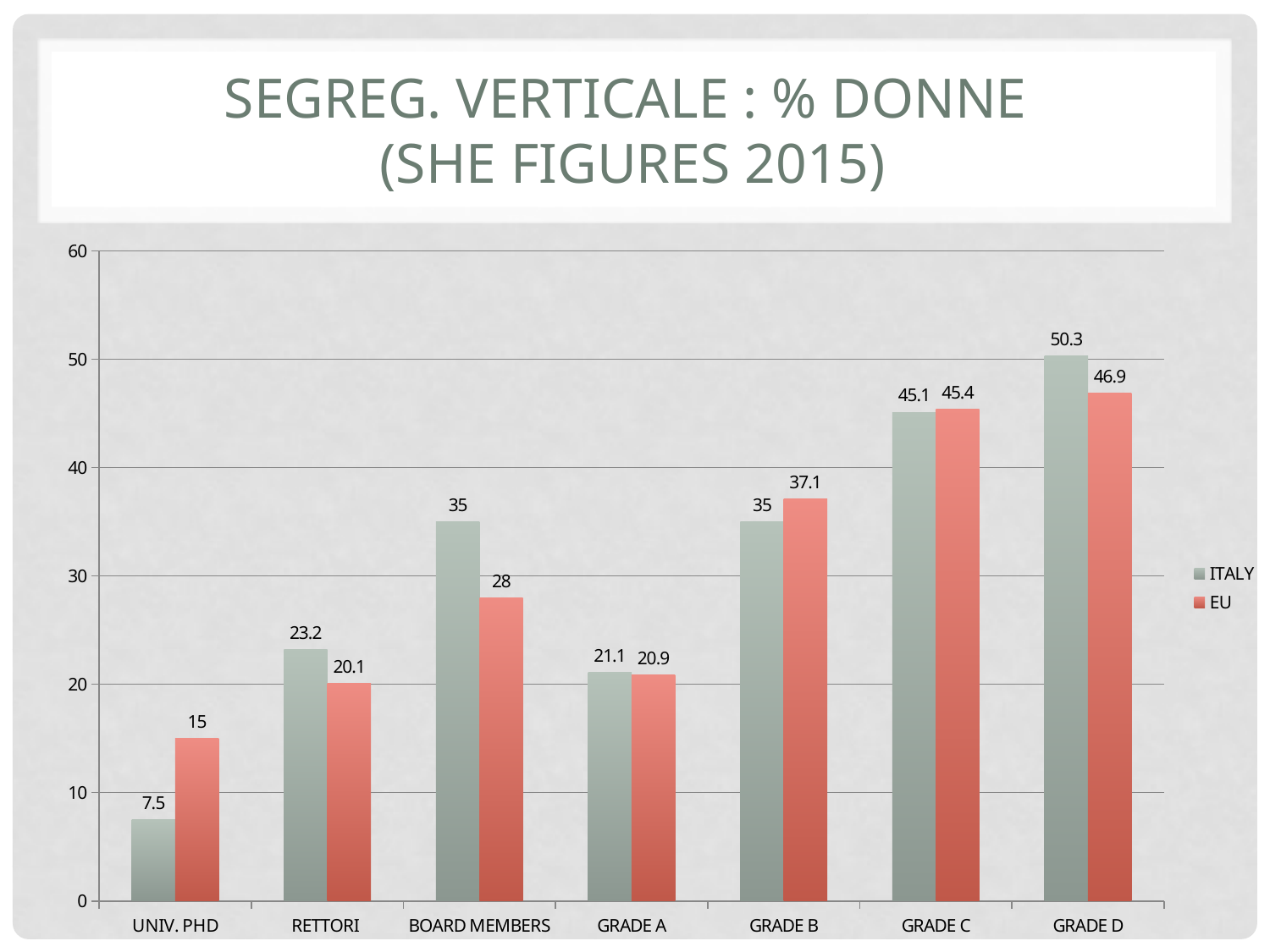
What is the EU value for BOARD MEMBERS? 28 What is the title of the chart on the slide? SEGREG. VERTICALE : % DONNE (SHE FIGURES 2015) What is the difference between the ITALY and EU values for RETTORI? 3.1 Is the ITALY value for GRADE D greater or less than 50? greater What kind of chart is shown on the slide? bar chart How many series does the legend list? 2 Which category has the highest ITALY value? GRADE D Which category has the lowest EU value? UNIV. PHD For UNIV. PHD, which series has the larger value, ITALY or EU? EU What is the EU value for GRADE B? 37.1 How many categories are shown on the x axis? 7 What is the ITALY value for UNIV. PHD? 7.5